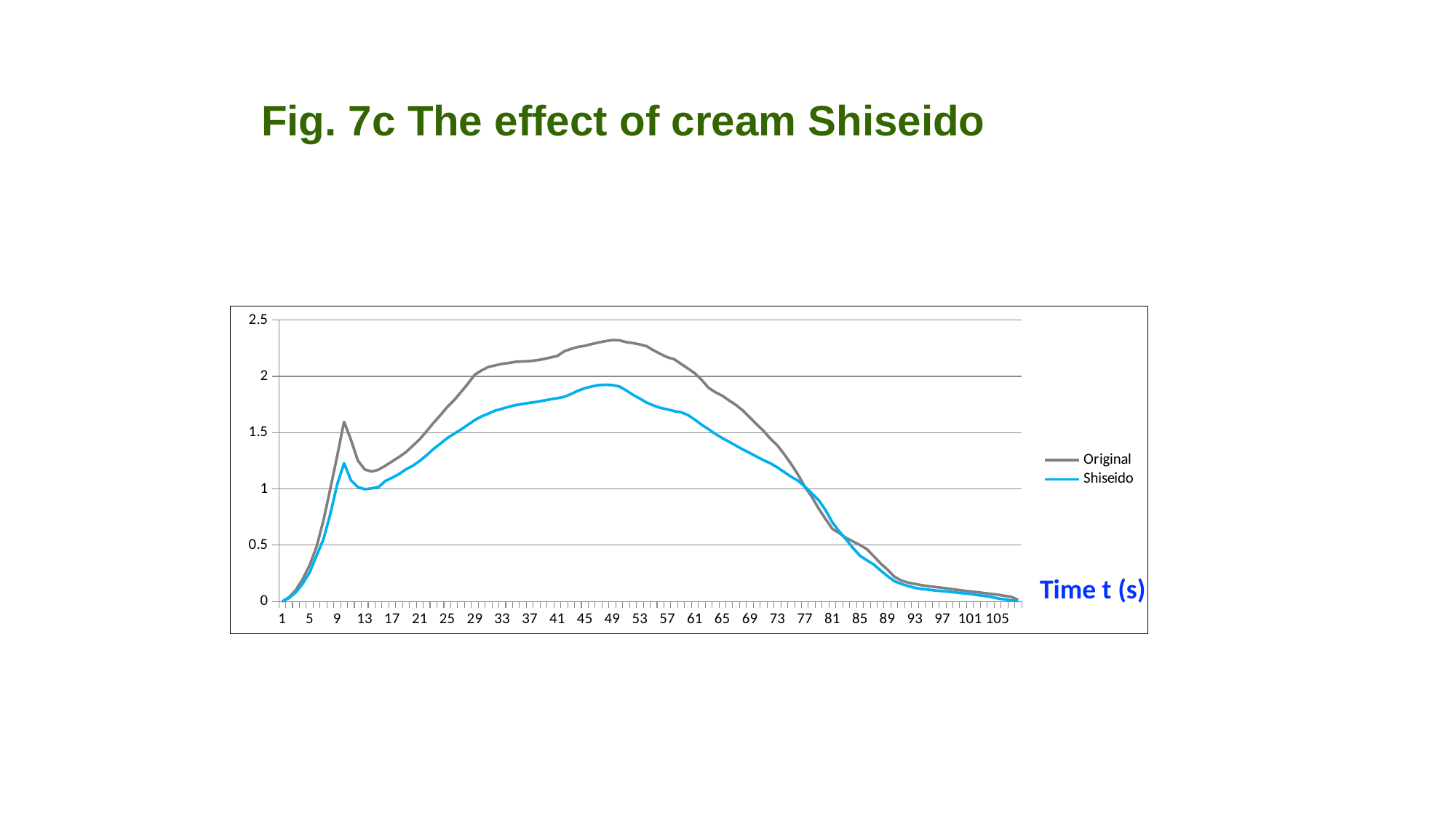
What are the two series named in the legend? Original and Shiseido Is the value of the Original series at time 33 greater or less than 2? greater Is the value of the Shiseido series at time 49 greater or less than 2? less How many series does the legend list? 2 Which series reaches the higher peak value overall? Original At time 49, which series has the higher value, Original or Shiseido? Original Do the values of the Original series rise or fall between time 49 and time 105? fall Is the value of the Original series at time 49 greater or less than 2? greater What kind of chart is shown on the slide? line chart What is the label of the x axis? Time t (s)